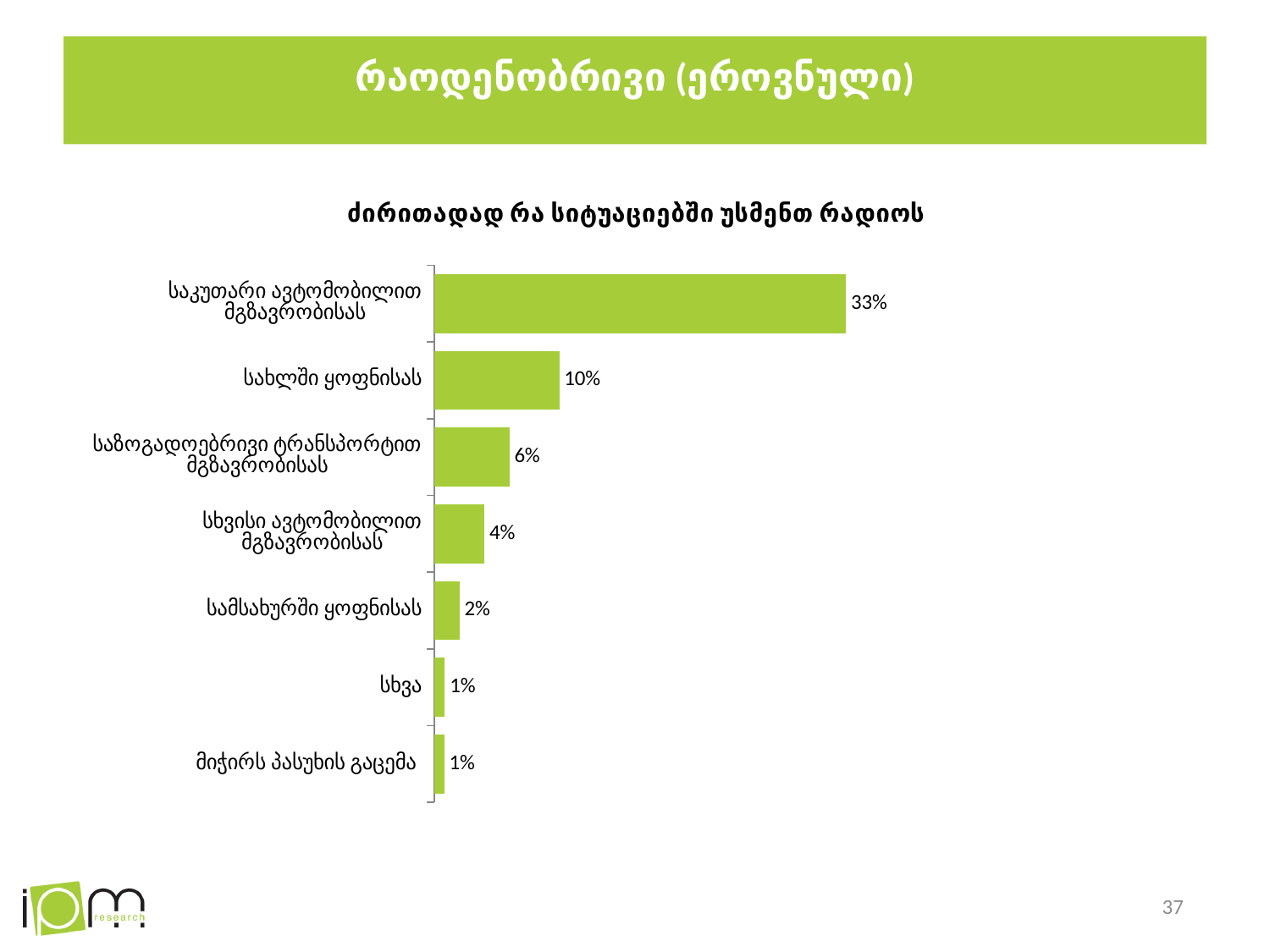
What is the difference between the values for "საზოგადოებრივი ტრანსპორტით მგზავრობისას" and "სხვისი ავტომობილით მგზავრობისას"? 2% What value is shown for "სხვისი ავტომობილით მგზავრობისას"? 4% What value is shown for "სახლში ყოფნისას"? 10% What value is shown for "საკუთარი ავტომობილით მგზავრობისას"? 33% What is the title of the chart? ძირითადად რა სიტუაციებში უსმენთ რადიოს Which category has the highest value? საკუთარი ავტომობილით მგზავრობისას Which is larger: the value for "სახლში ყოფნისას" or the value for "სამსახურში ყოფნისას"? სახლში ყოფნისას How many categories are shown in the chart? 7 What value is shown for "საზოგადოებრივი ტრანსპორტით მგზავრობისას"? 6% What type of chart is shown on the slide? Bar chart What is the difference between the values for "საკუთარი ავტომობილით მგზავრობისას" and "სახლში ყოფნისას"? 23% What value is shown for "სამსახურში ყოფნისას"? 2%